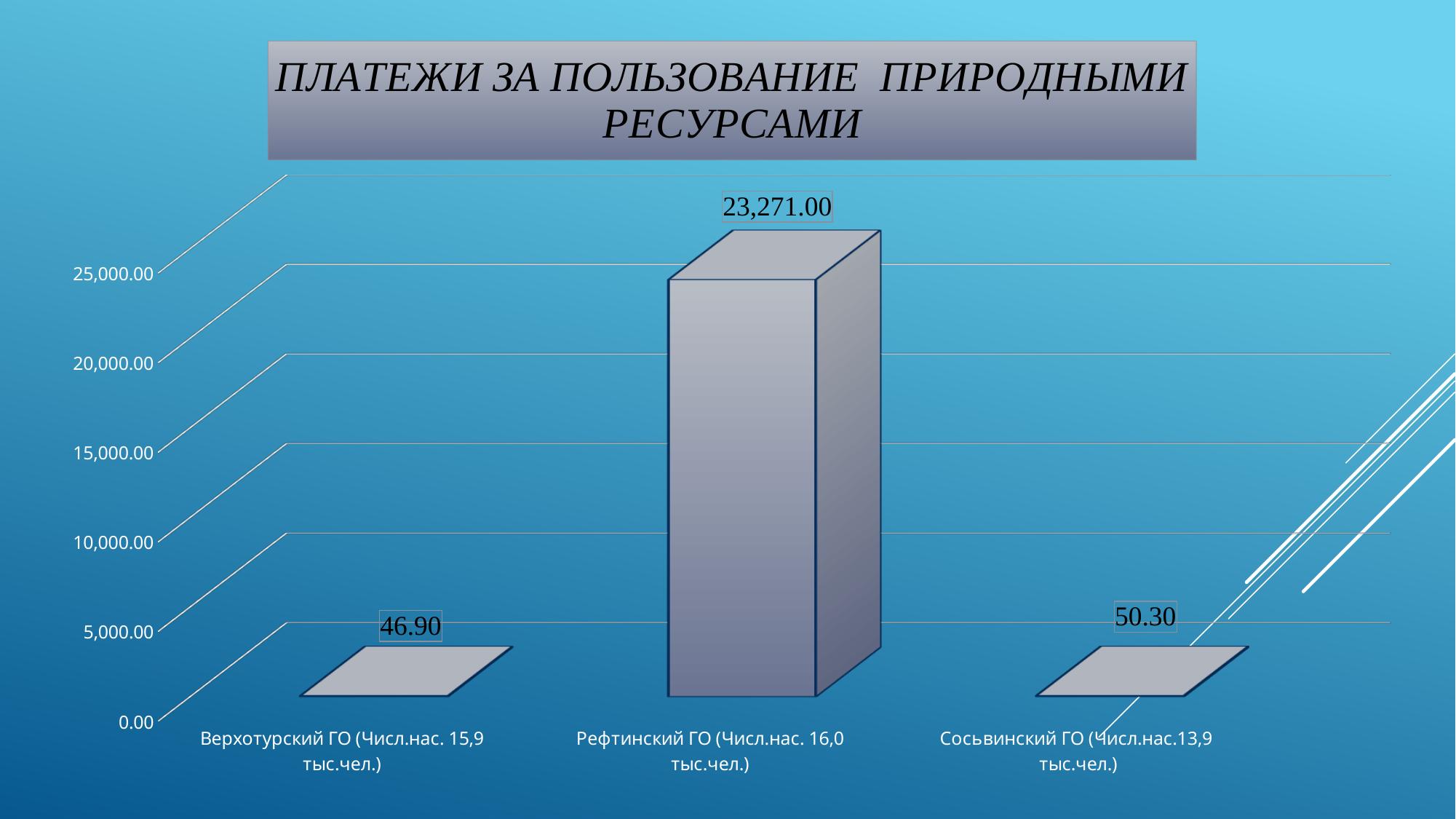
What is the difference between the values for Сосьвинский ГО and Верхотурский ГО? 3.40 How many categories are shown on the chart? 3 What kind of chart is shown on the slide? bar chart Which is larger, the value for Сосьвинский ГО or the value for Верхотурский ГО? Сосьвинский ГО Is the value for Рефтинский ГО greater or less than 20,000.00? greater What is the difference between the values for Рефтинский ГО and Сосьвинский ГО? 23,220.70 What is the title of the chart? ПЛАТЕЖИ ЗА ПОЛЬЗОВАНИЕ ПРИРОДНЫМИ РЕСУРСАМИ What is the value for Сосьвинский ГО? 50.30 Which category has the highest value? Рефтинский ГО What is the value for Верхотурский ГО? 46.90 Which category has the lowest value? Верхотурский ГО What is the value for Рефтинский ГО? 23,271.00